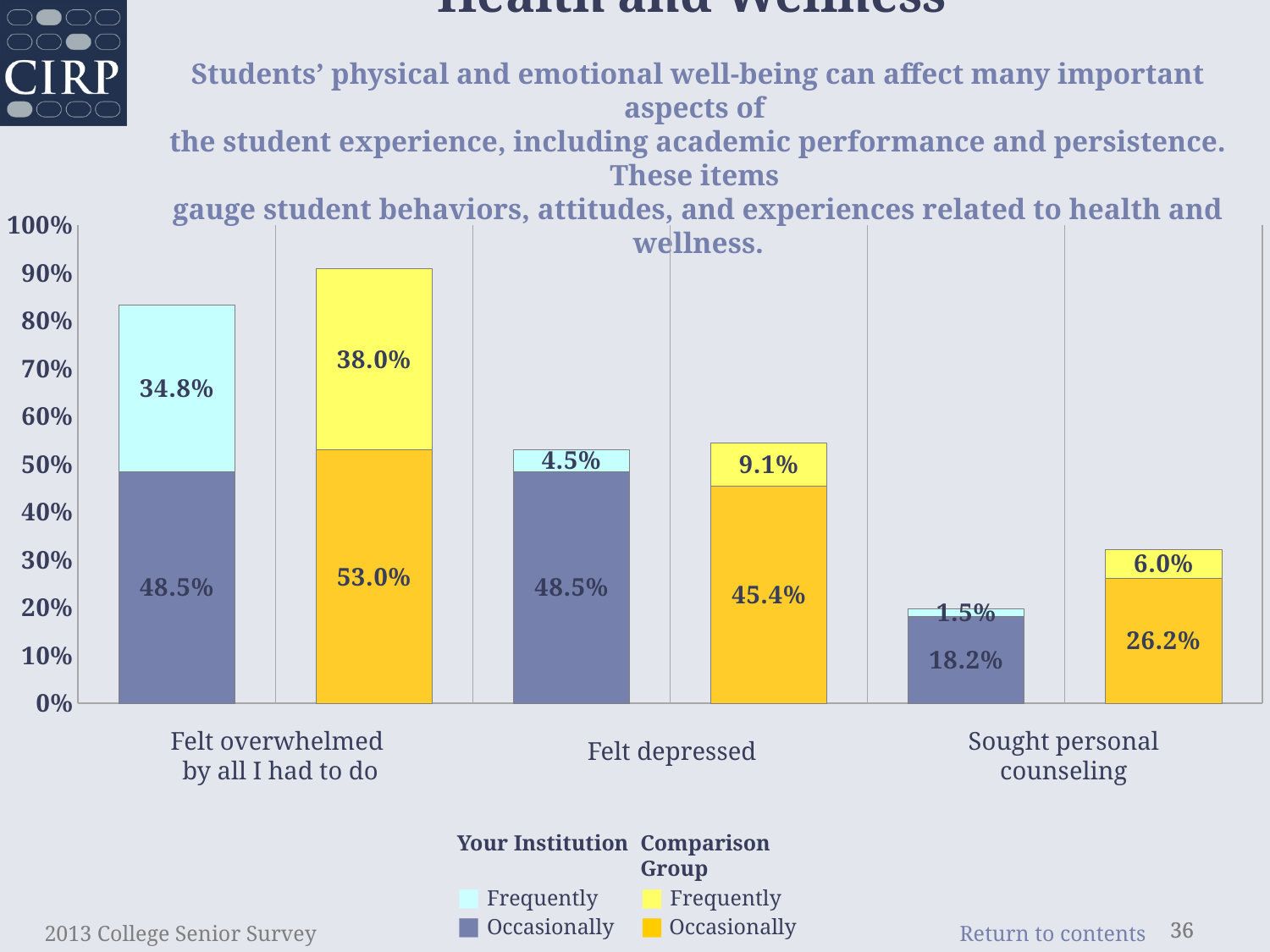
What is the 'Occasionally' value for the Comparison Group for 'Sought personal counseling'? 26.2% What is the 'Frequently' value for the Comparison Group for 'Felt depressed'? 9.1% Which category has the highest Comparison Group 'Occasionally' value? Felt overwhelmed by all I had to do What is the total stacked value of the Comparison Group bar for 'Sought personal counseling'? 32.2% What kind of chart is shown on the slide? Stacked bar chart Which is larger for 'Felt depressed': the Your Institution 'Frequently' value or the Comparison Group 'Frequently' value? Comparison Group What is the total stacked value of the Your Institution bar for 'Felt overwhelmed by all I had to do'? 83.3% Which category has the lowest Your Institution 'Frequently' value? Sought personal counseling What percentage of students at Your Institution reported 'Occasionally' for 'Felt overwhelmed by all I had to do'? 48.5% How many series does the legend list? 4 How many categories are shown on the x axis? 3 What is the difference between the Comparison Group and Your Institution 'Frequently' values for 'Felt overwhelmed by all I had to do'? 3.2%